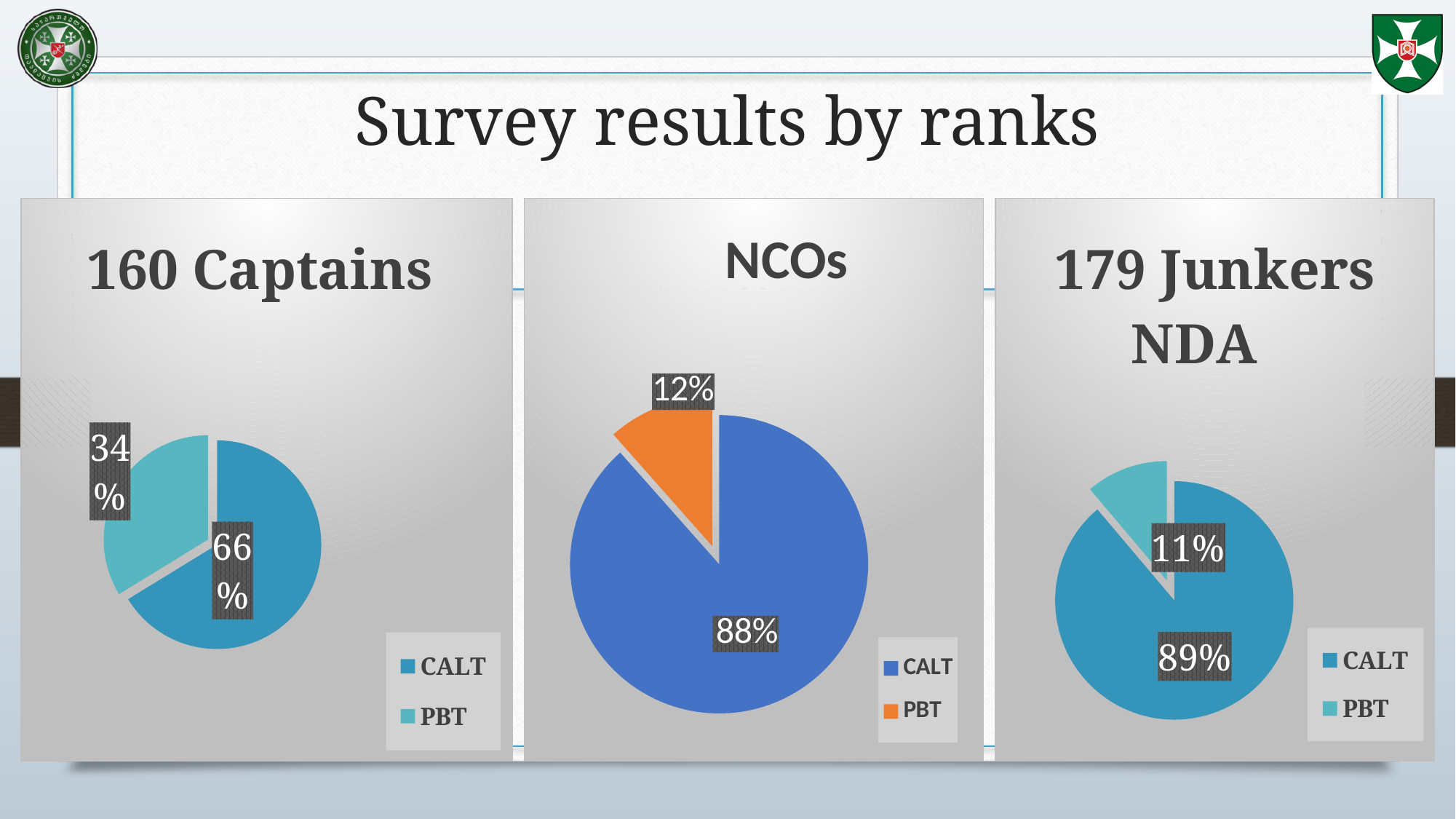
In the 179 Junkers NDA chart, what share of the pie is CALT? 89% In the NCOs chart, which slice is the smallest? PBT In the NCOs chart, what share of the pie is CALT? 88% In the 160 Captains chart, what share of the pie is PBT? 34% What kind of chart is the NCOs chart? Pie chart In the 160 Captains chart, which slice is the largest? CALT In the 179 Junkers NDA chart, which is larger, CALT or PBT? CALT How many entries does the legend of the 179 Junkers NDA chart list? 2 In the 160 Captains chart, what is the difference between the CALT and PBT shares? 32%